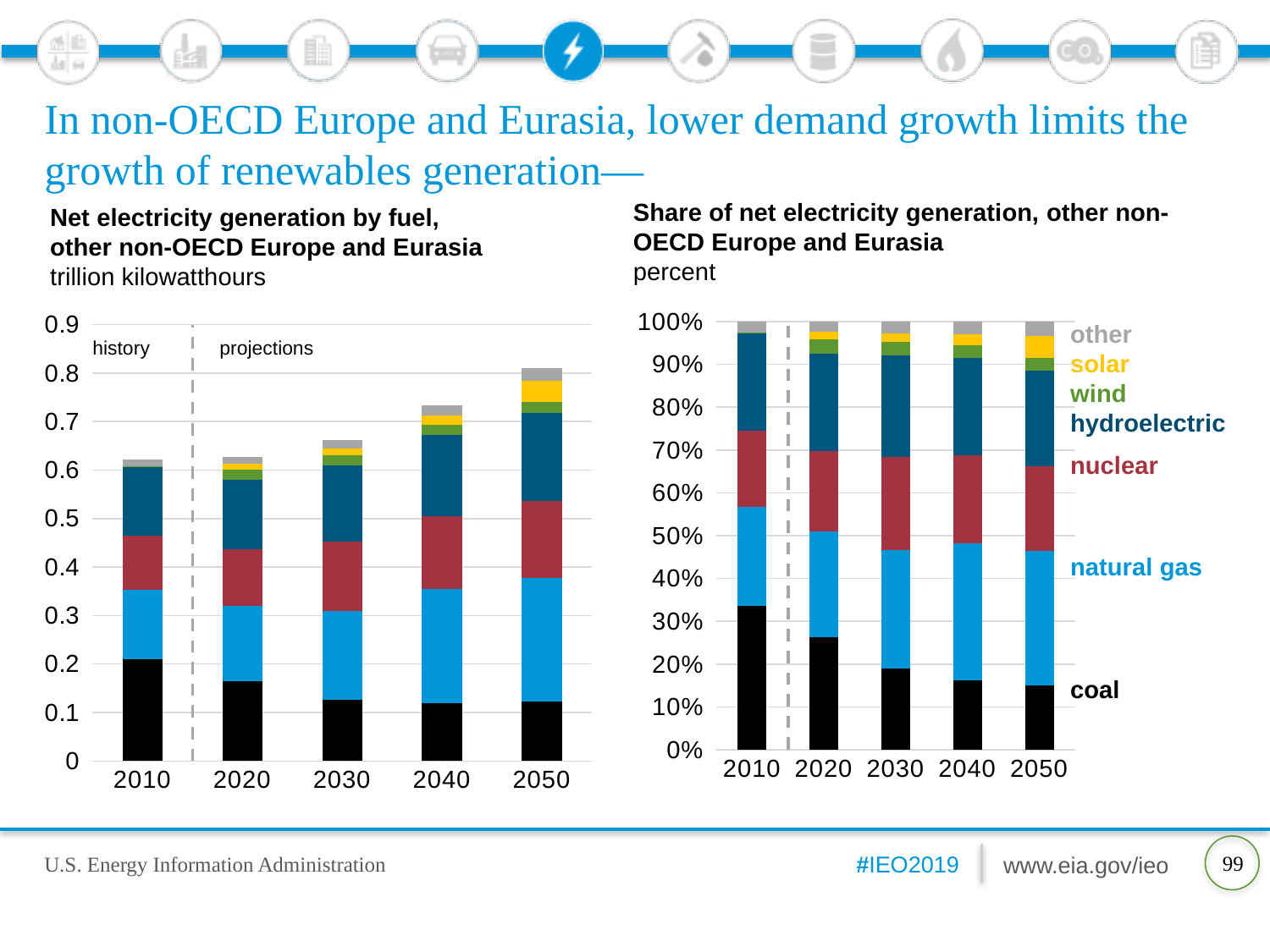
In the left chart, 'Net electricity generation by fuel', is the total bar for 2040 greater or less than 0.7? greater How many fuel series are labelled on the right chart, 'Share of net electricity generation, other non-OECD Europe and Eurasia'? 7 In the left chart, 'Net electricity generation by fuel', is the total bar for 2030 greater or less than 0.7? less In the right chart, 'Share of net electricity generation', is the coal share in 2050 greater or less than 20%? less What kind of chart is the left chart, 'Net electricity generation by fuel, other non-OECD Europe and Eurasia'? stacked bar chart What unit is used on the left chart, 'Net electricity generation by fuel, other non-OECD Europe and Eurasia'? trillion kilowatthours In the right chart, 'Share of net electricity generation', is the coal share larger in 2010 or in 2040? 2010 In the left chart, 'Net electricity generation by fuel', which year has the highest total bar? 2050 In the right chart, 'Share of net electricity generation', does the coal share rise or fall from 2010 to 2050? fall How many years are shown on the x axis of the right chart, 'Share of net electricity generation, other non-OECD Europe and Eurasia'? 5 In the right chart, 'Share of net electricity generation', which fuel is shown at the bottom of each stacked bar? coal